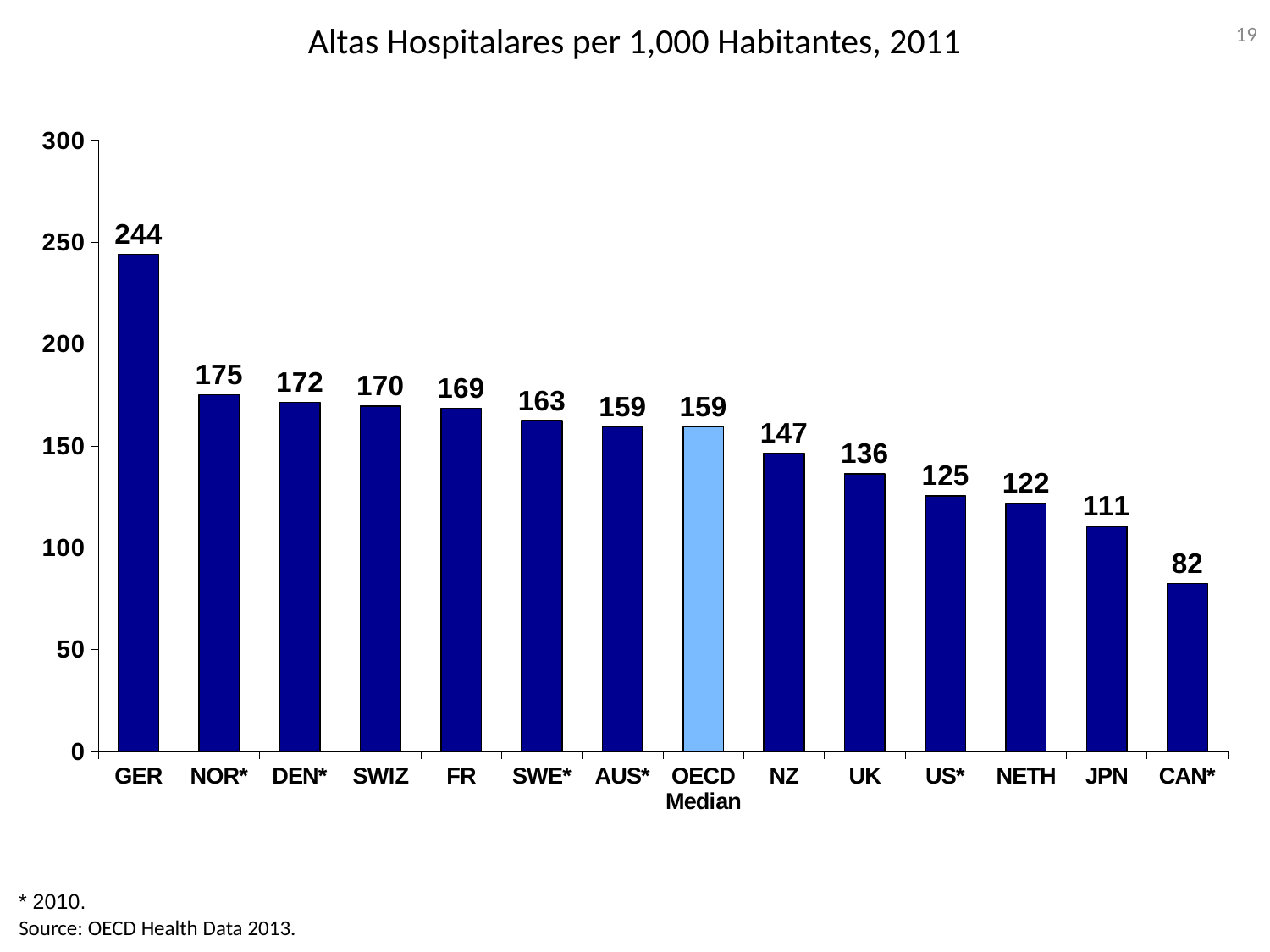
Which category has the highest value? GER Which category has the lowest value? CAN* What kind of chart is this? bar chart What is the value for GER? 244 What is the value for US*? 125 Which is larger, the value for NZ or the value for NETH? NZ What is the difference between the values for GER and NOR*? 69 What is the title of the chart? Altas Hospitalares per 1,000 Habitantes, 2011 Do the values rise or fall from left to right along the x axis? fall How many categories are shown on the x axis? 14 What is the difference between the values for UK and CAN*? 54 What is the value for the OECD Median? 159